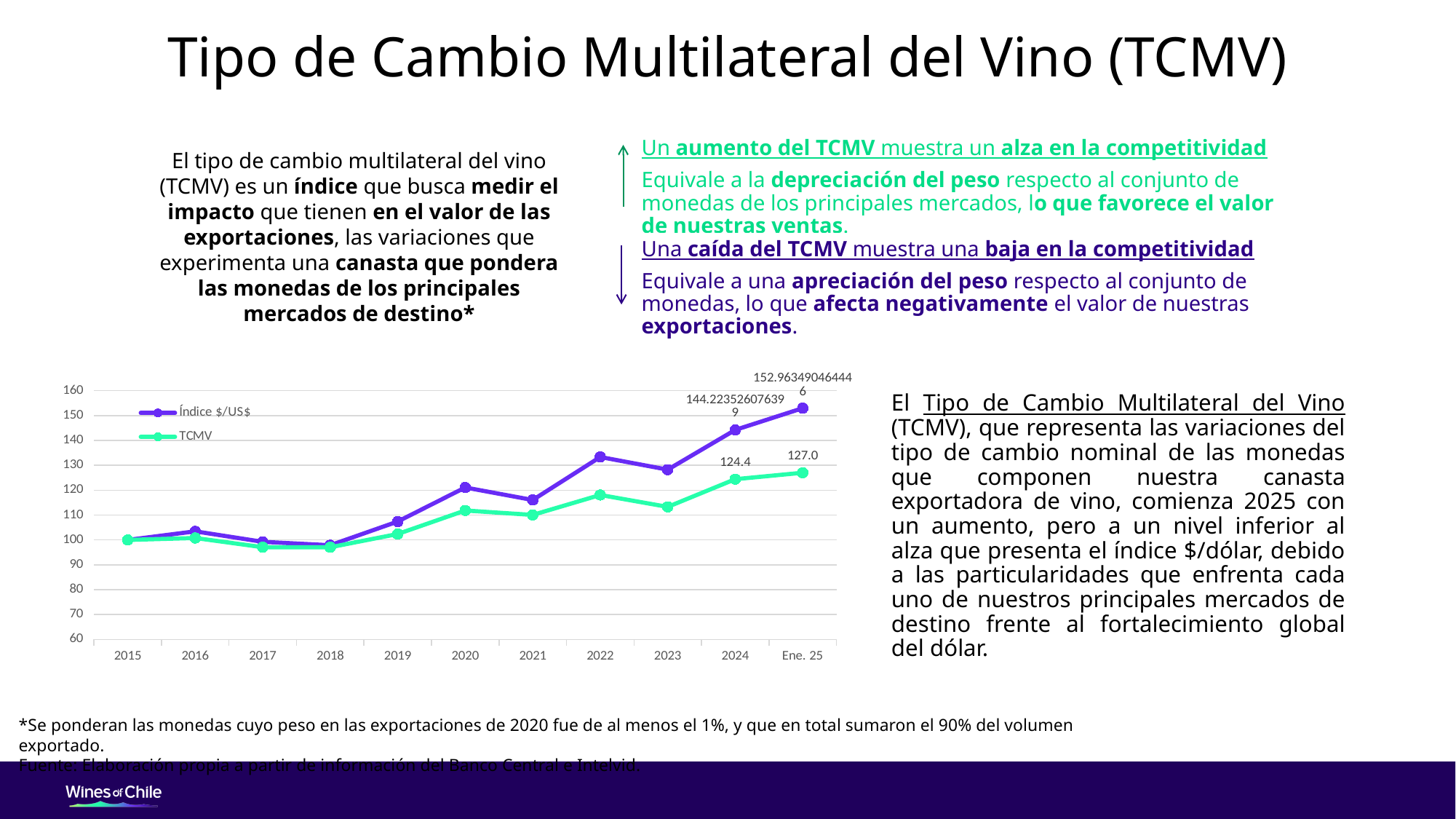
What kind of chart is shown on the slide? Line chart What is the value of TCMV in Ene. 25? 127.0 How many series does the chart legend list? 2 Is the value of Índice $/US$ in 2023 greater or less than 120? greater How many time periods are shown on the x axis of the chart? 11 Is the value of TCMV in 2017 greater or less than 100? less Is the value of Índice $/US$ in 2022 greater or less than 130? greater What is the difference between the TCMV values for Ene. 25 and 2024? 2.6 What is the value of TCMV in 2024? 124.4 In which period does the Índice $/US$ series reach its highest value? Ene. 25 In 2024, which series has the larger value, Índice $/US$ or TCMV? Índice $/US$